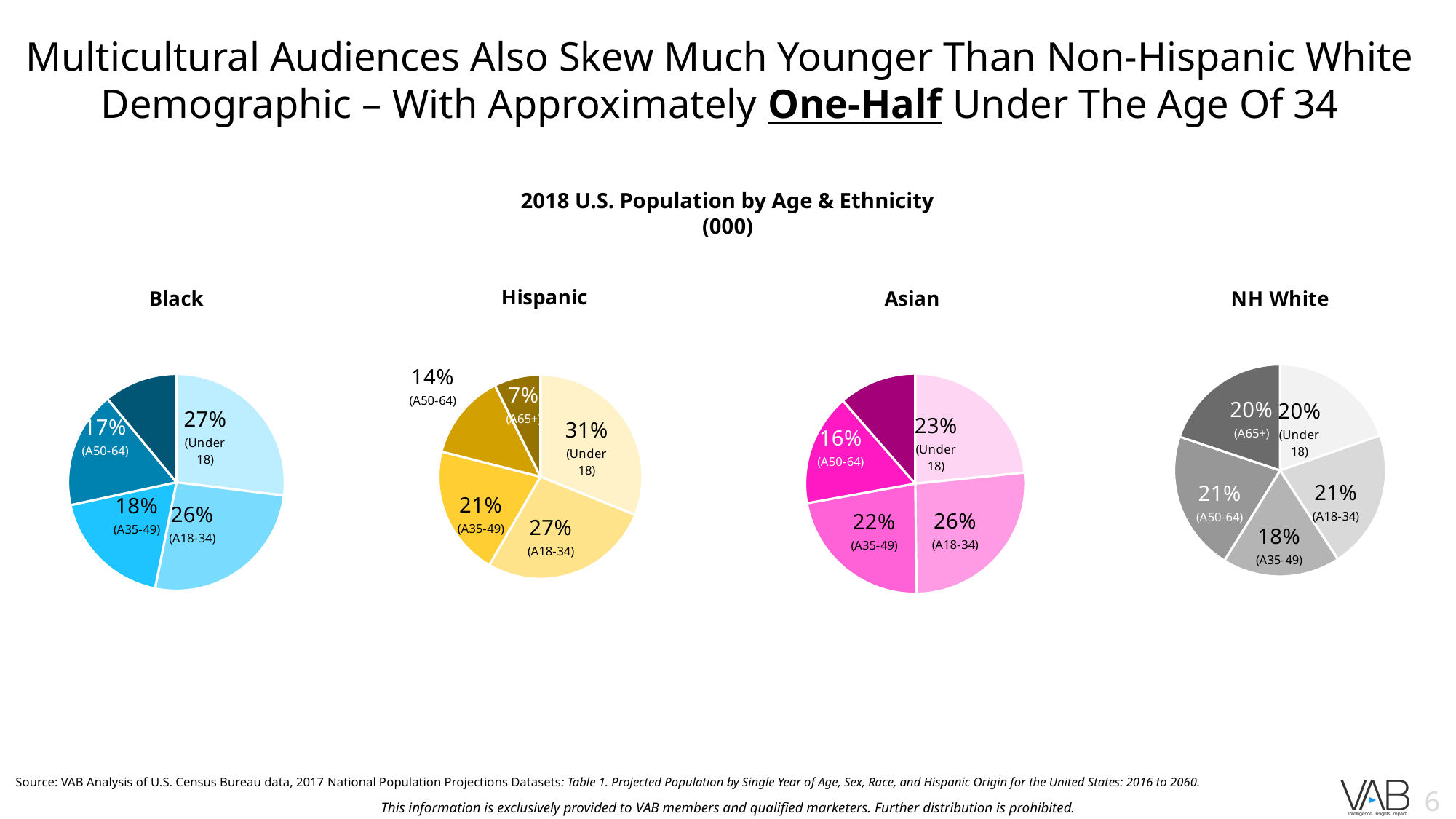
In the Hispanic pie chart, what is the difference between the Under 18 share and the A50-64 share? 17 percentage points How many slices does the Hispanic pie chart have? 5 How many pie charts are shown on the slide? 4 What type of chart is used to show the Asian population by age? Pie chart In the Asian pie chart, what share is in the A50-64 age group? 16% Which is larger: the Under 18 share in the Black pie chart or the Under 18 share in the NH White pie chart? Black In the Hispanic pie chart, which age group has the smallest share? A65+ In the NH White pie chart, what percentage is A65+? 20% In the Black pie chart, what percentage is in the A35-49 age group? 18% In the Asian pie chart, which age group has the largest share? A18-34 In the Hispanic pie chart, what share of the population is Under 18? 31% In the NH White pie chart, which age group has the smallest share? A35-49